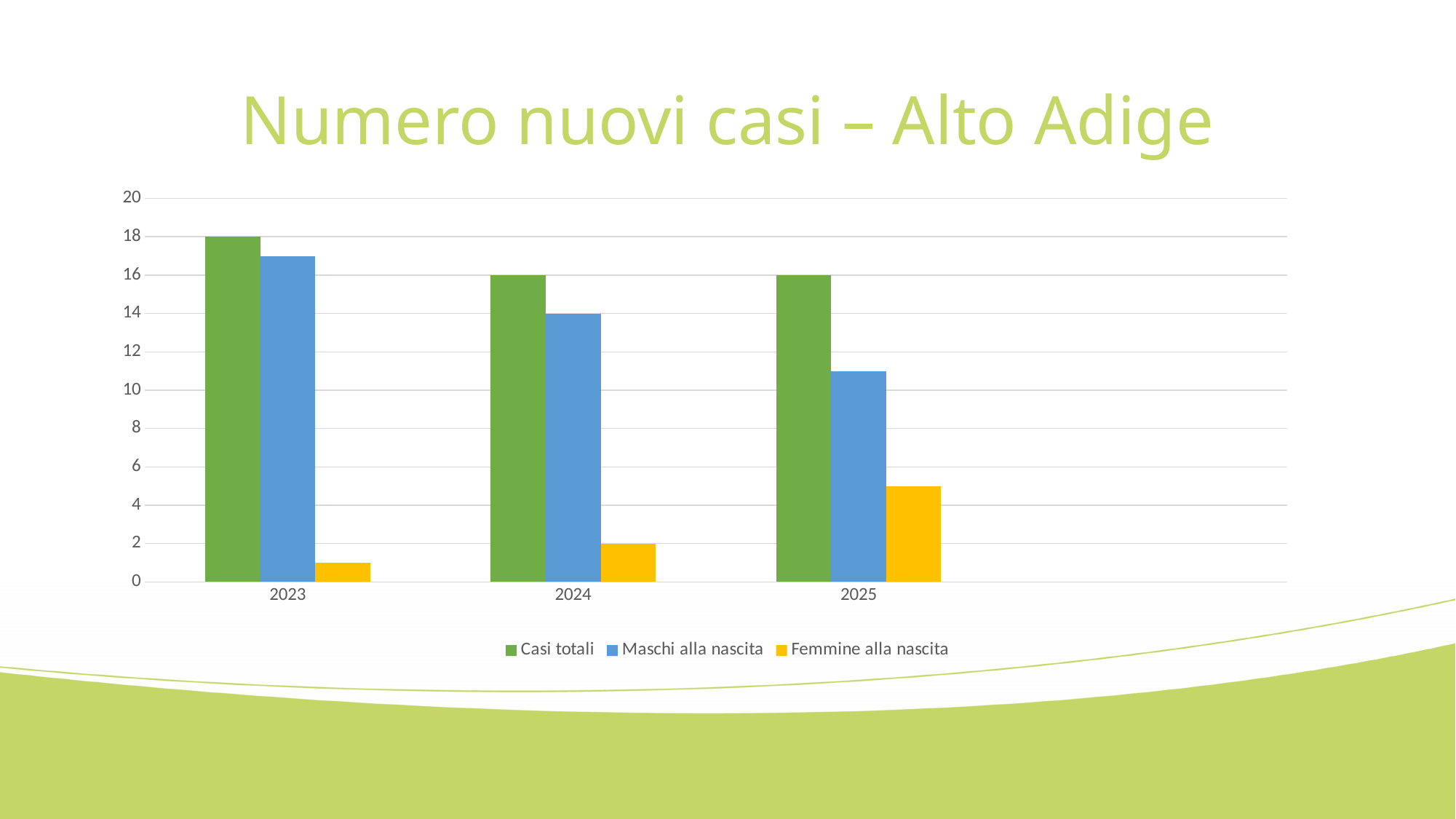
Which is larger in 2025: Maschi alla nascita or Femmine alla nascita? Maschi alla nascita What type of chart is shown on the slide? Bar chart How many series does the legend list? 3 Does Femmine alla nascita rise or fall from 2023 to 2025? Rise Is the value for Maschi alla nascita in 2023 greater or less than 10? greater What is the value of Maschi alla nascita for 2024? 14 What is the difference between Casi totali in 2023 and Casi totali in 2024? 2 What is the value of Casi totali for 2023? 18 What is the value of Femmine alla nascita for 2024? 2 In which year is Femmine alla nascita lowest? 2023 In which year is Casi totali highest? 2023 What is the value of Casi totali for 2024? 16